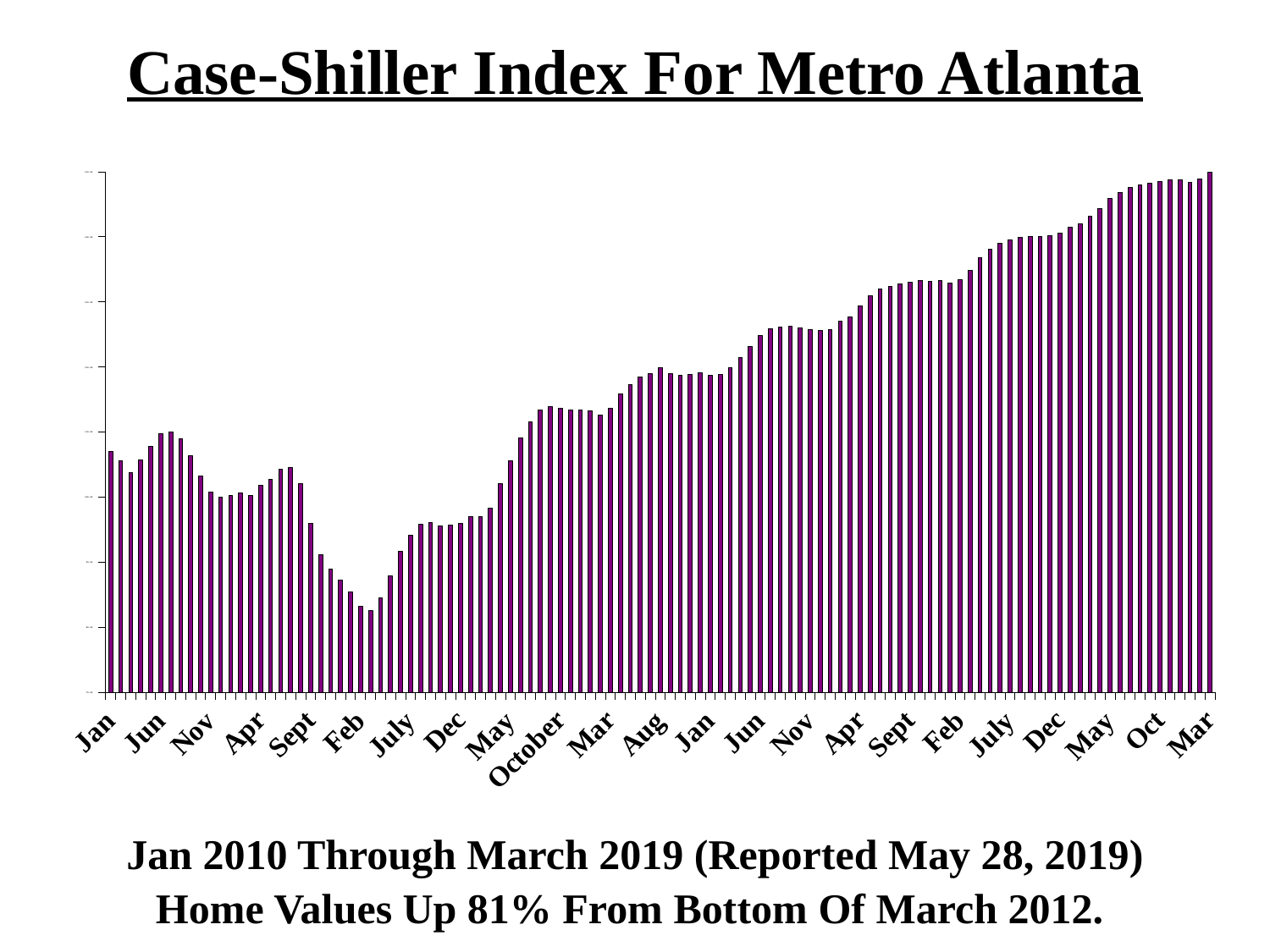
Between the first 'Jun' label and the first 'Feb' label, do the bars generally rise or fall? fall What is the title of the chart? Case-Shiller Index For Metro Atlanta Is the last bar on the right higher or lower than the first bar on the left? higher What kind of chart is shown on the slide? bar chart Which is larger: the bar at the 'Oct' label near the right or the bar at the 'Aug' label in the middle? Oct Which x-axis label corresponds to the tallest bar in the chart? Mar (the last label on the right) Between the first 'Feb' label and the first 'July' label, do the bars rise or fall? rise According to the text below the chart, by what percentage are home values up from the bottom of March 2012? 81% Is the lowest bar in the chart located near the left, the middle, or the right of the chart? left Which is larger: the bar at the first 'Jan' label or the bar at the first 'Feb' label? Jan How many month labels are printed along the x axis? 23 From the first 'Dec' label to the final 'Mar' label, do the bars generally rise or fall? rise